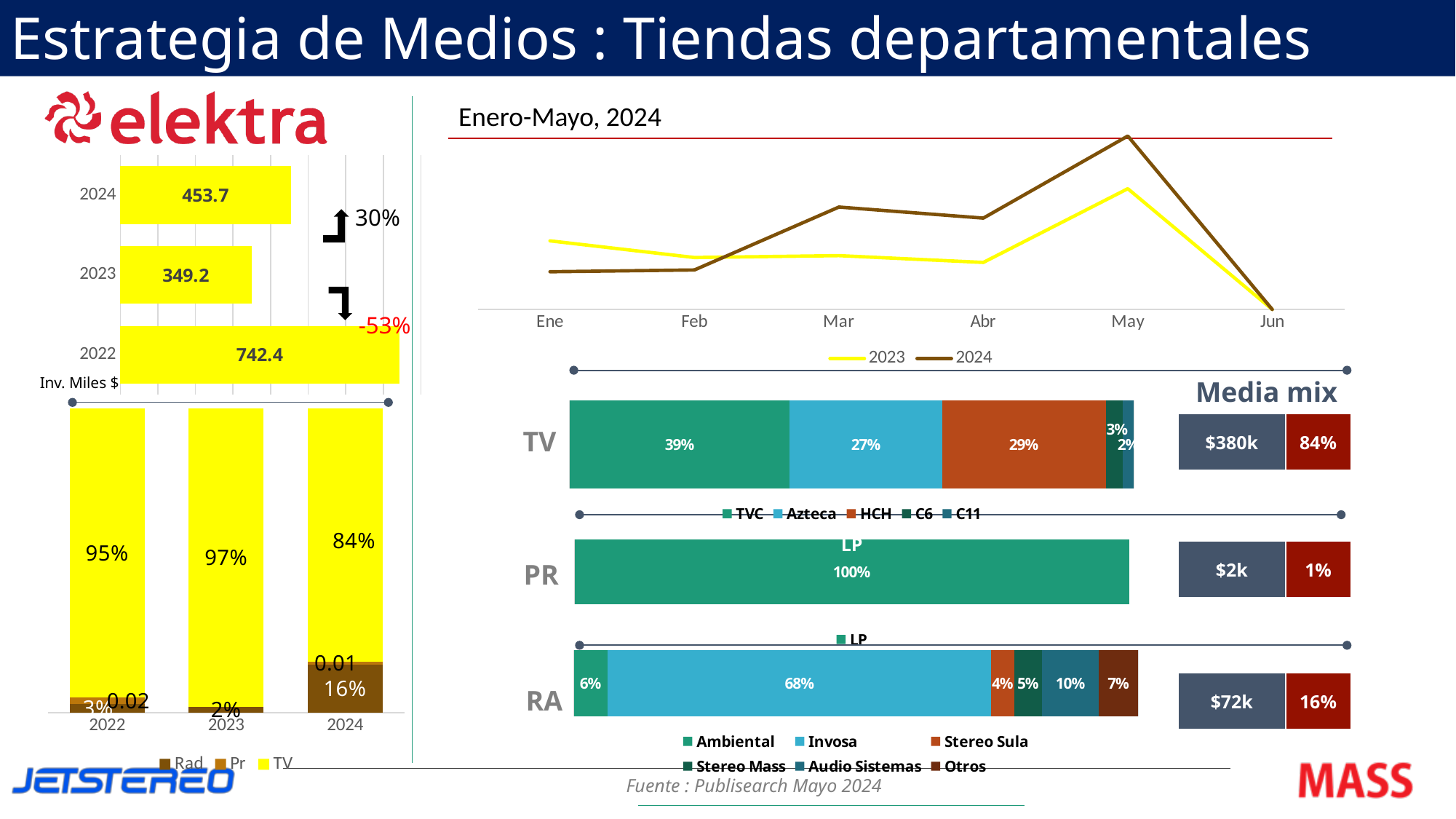
In the top-left horizontal bar chart (Inv. Miles $), which year has the lowest value? 2023 In the top-left horizontal bar chart (Inv. Miles $), which year has the highest value? 2022 In the RA stacked bar on the right, which station has the largest share? Invosa In the line chart titled 'Enero-Mayo, 2024', how many series does the legend list? 2 In the top-left horizontal bar chart (Inv. Miles $), what is the difference between the 2024 and 2023 values? 104.5 In the bottom-left stacked bar chart, what share does TV have in 2024? 84% In the line chart titled 'Enero-Mayo, 2024', in which month does the 2024 line reach its highest point? May In the Media mix boxes on the right, what is the dollar amount shown for RA? $72k In the top-left horizontal bar chart (Inv. Miles $), what is the value for 2022? 742.4 In the top-left horizontal bar chart (Inv. Miles $), what is the value for 2024? 453.7 In the bottom-left stacked bar chart, how many series does the legend list? 3 In the TV stacked bar on the right, what share does Azteca have? 27%